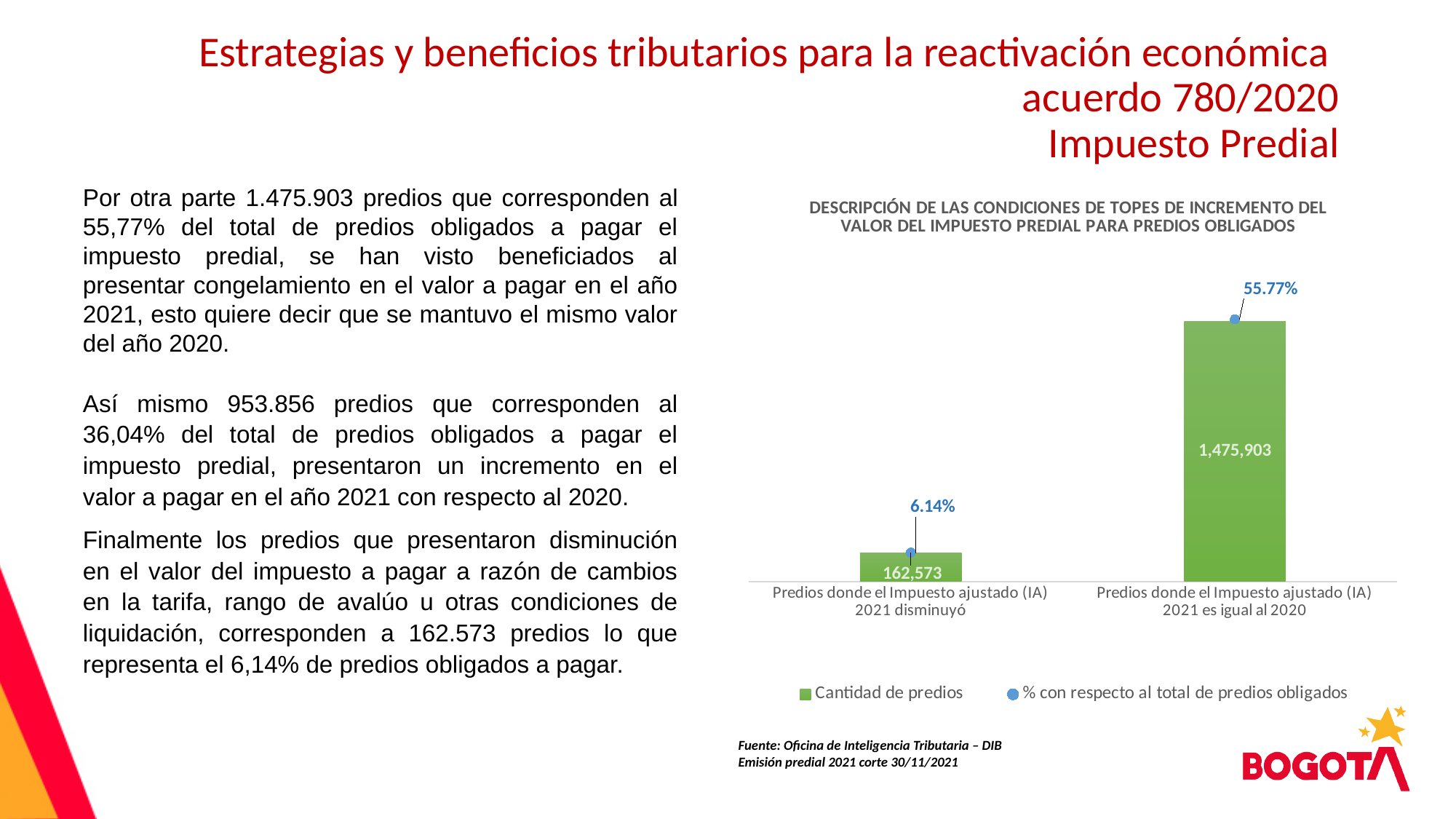
How many series does the chart legend list? 2 Which category has the highest 'Cantidad de predios'? Predios donde el Impuesto ajustado (IA) 2021 es igual al 2020 What type of chart is used to show 'Cantidad de predios'? Bar chart What is the difference in 'Cantidad de predios' between the two categories shown in the chart? 1,313,330 What percentage with respect to the total of obligated properties is shown for 'Predios donde el Impuesto ajustado (IA) 2021 es igual al 2020'? 55.77% What is the 'Cantidad de predios' value for 'Predios donde el Impuesto ajustado (IA) 2021 disminuyó'? 162,573 How many categories are shown on the x axis of the chart? 2 Which category has the lowest percentage with respect to the total of obligated properties? Predios donde el Impuesto ajustado (IA) 2021 disminuyó What percentage with respect to the total of obligated properties is shown for 'Predios donde el Impuesto ajustado (IA) 2021 disminuyó'? 6.14% Which is larger: the 'Cantidad de predios' for properties whose adjusted tax decreased, or for properties whose adjusted tax equals 2020? Predios donde el Impuesto ajustado (IA) 2021 es igual al 2020 What is the difference in percentage points between 55.77% and 6.14% shown in the chart? 49.63 What is the 'Cantidad de predios' value for 'Predios donde el Impuesto ajustado (IA) 2021 es igual al 2020'? 1,475,903